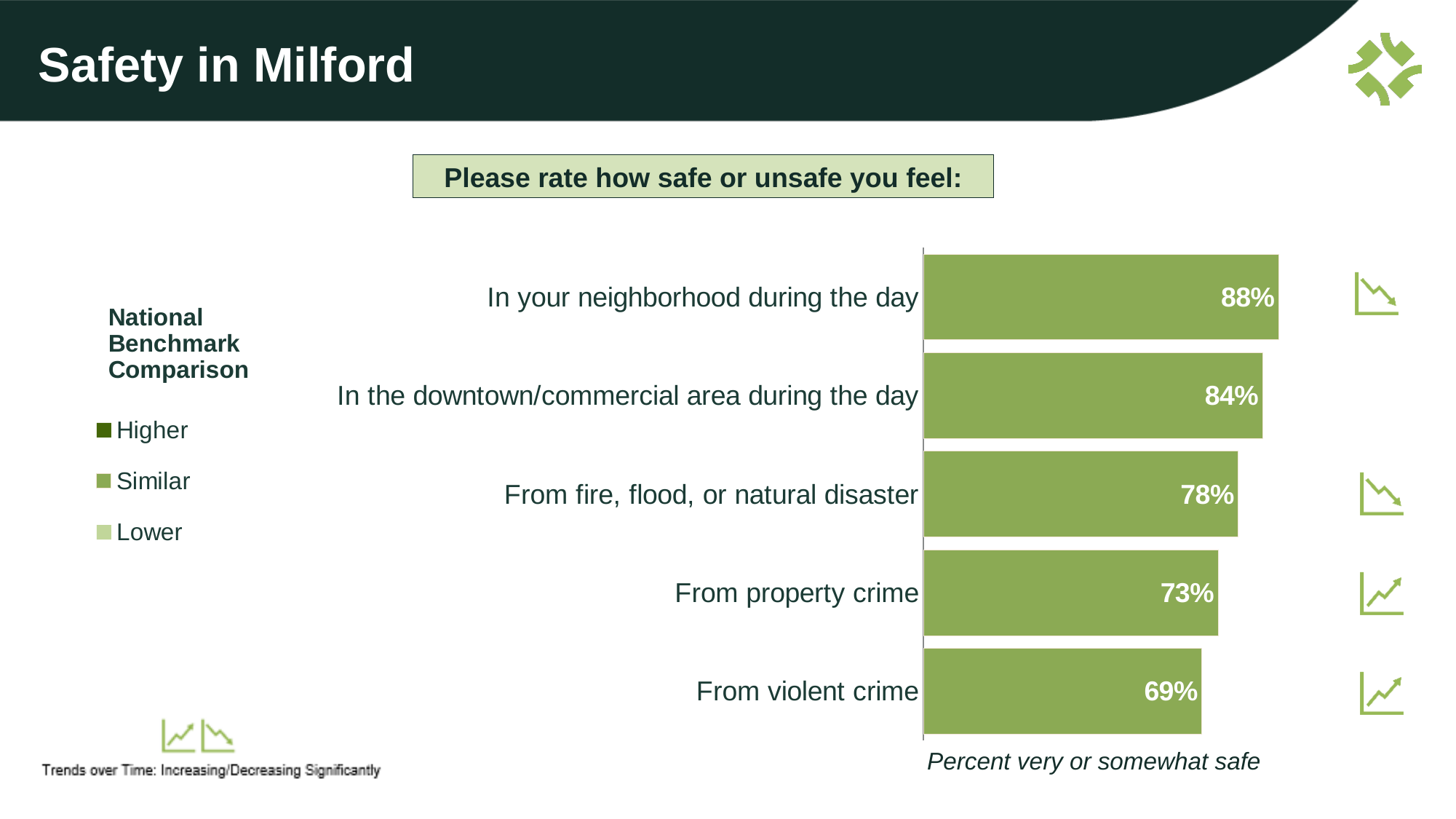
What is the difference between the values for 'In your neighborhood during the day' and 'From violent crime'? 19% What is the difference between the values for 'From fire, flood, or natural disaster' and 'From property crime'? 5% What is the value for 'From violent crime'? 69% Which category has the highest percent very or somewhat safe? In your neighborhood during the day What is the value for 'In the downtown/commercial area during the day'? 84% How many categories are shown in the chart? 5 Which category has the lowest percent very or somewhat safe? From violent crime What percent of respondents feel very or somewhat safe in their neighborhood during the day? 88% Which is larger: the value for 'From property crime' or the value for 'From violent crime'? From property crime What is the value for 'From fire, flood, or natural disaster'? 78% What kind of chart is shown on the slide? Bar chart What does the label below the chart say the bars represent? Percent very or somewhat safe